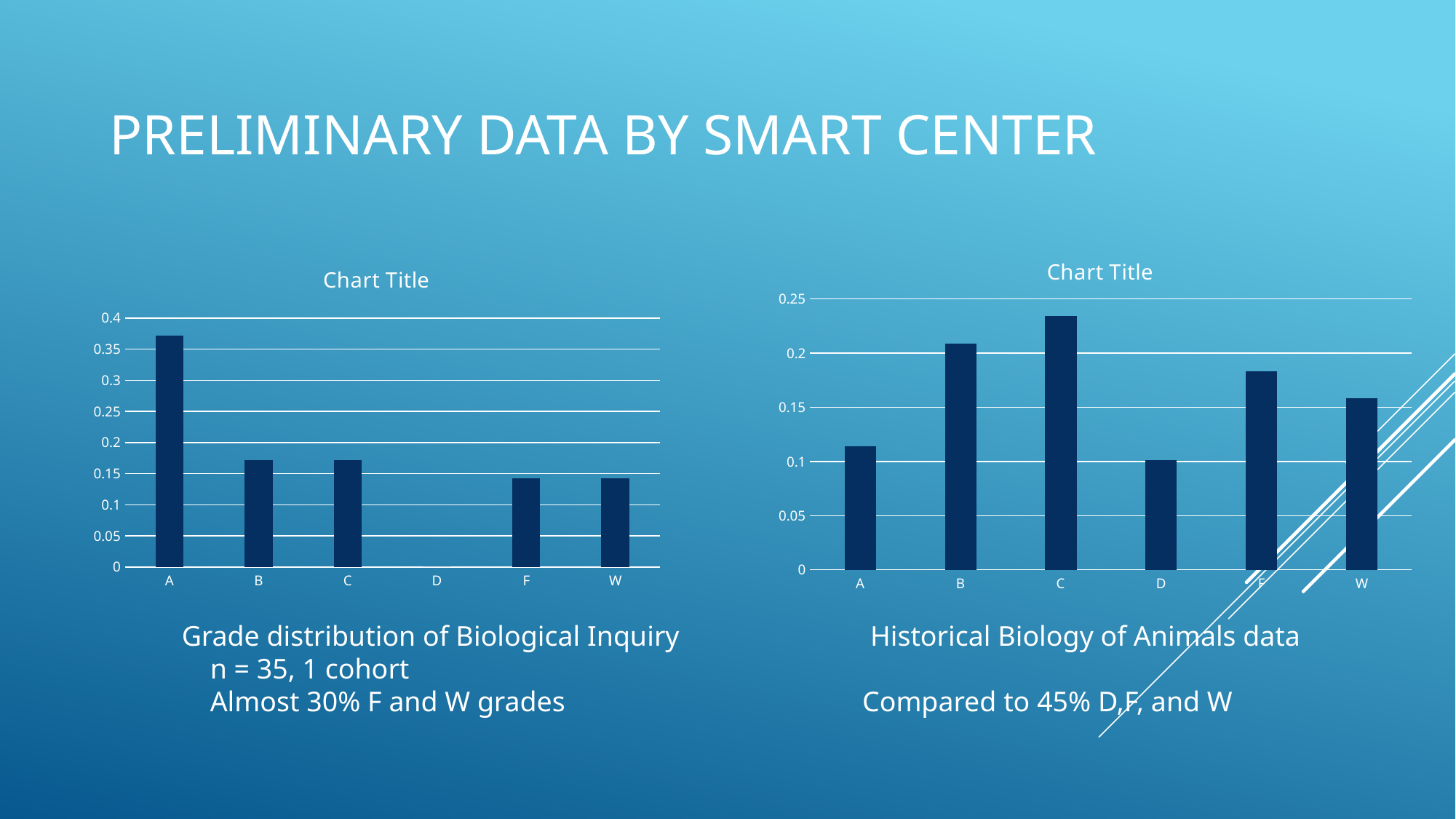
In the left chart, which is larger, the value for A or the value for F? A In the right chart, which category has the highest bar? C What is the title shown above the right chart? Chart Title In the left chart, which category has the highest bar? A In the right chart, is the value for W greater or less than 0.15? greater How many categories are shown on the x axis of the right chart? 6 In the left chart, which category has no visible bar (the lowest value)? D In the right chart, which is larger, the value for C or the value for B? C In the left chart, is the value for B greater or less than 0.2? less What kind of chart is the left chart on the slide? bar chart In the left chart, is the value for A greater or less than 0.35? greater